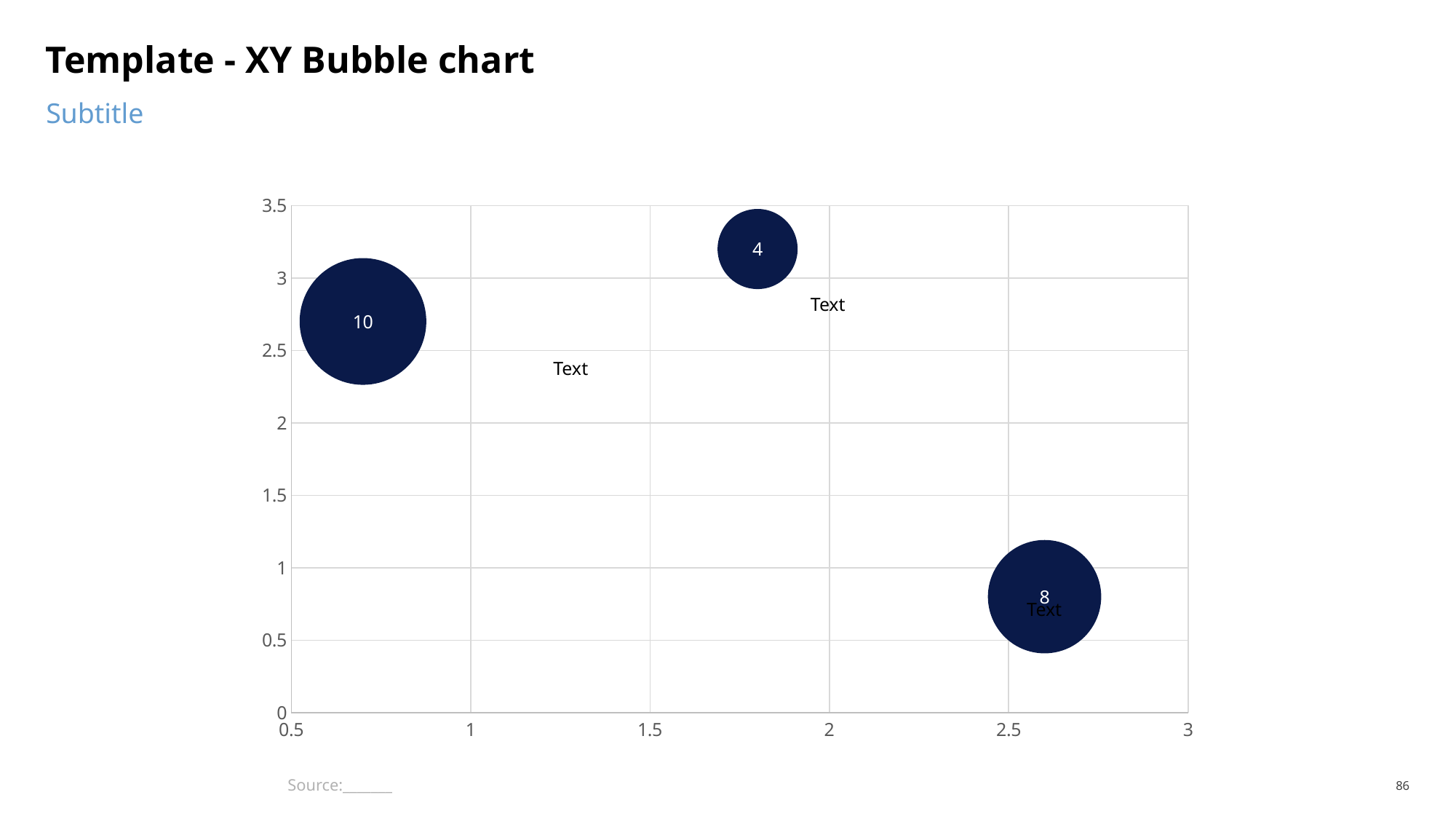
Is the y-axis position of the bubble labelled 4 greater or less than 3? greater Is the x-axis position of the bubble labelled 10 greater or less than 1? less How many bubbles are plotted on the chart? 3 What is the sum of the values printed on all three bubbles? 22 What is the value printed on the largest bubble? 10 Which bubble has the larger printed value, the one in the upper left or the one in the lower right? the one in the upper left (10) Is the y-axis position of the bubble labelled 8 greater or less than 1? less What is the title of the slide? Template - XY Bubble chart What kind of chart is shown on the slide? bubble chart What is the highest value shown on the y axis? 3.5 What is the value printed on the smallest bubble? 4 What is the difference between the values printed on the largest and smallest bubbles? 6